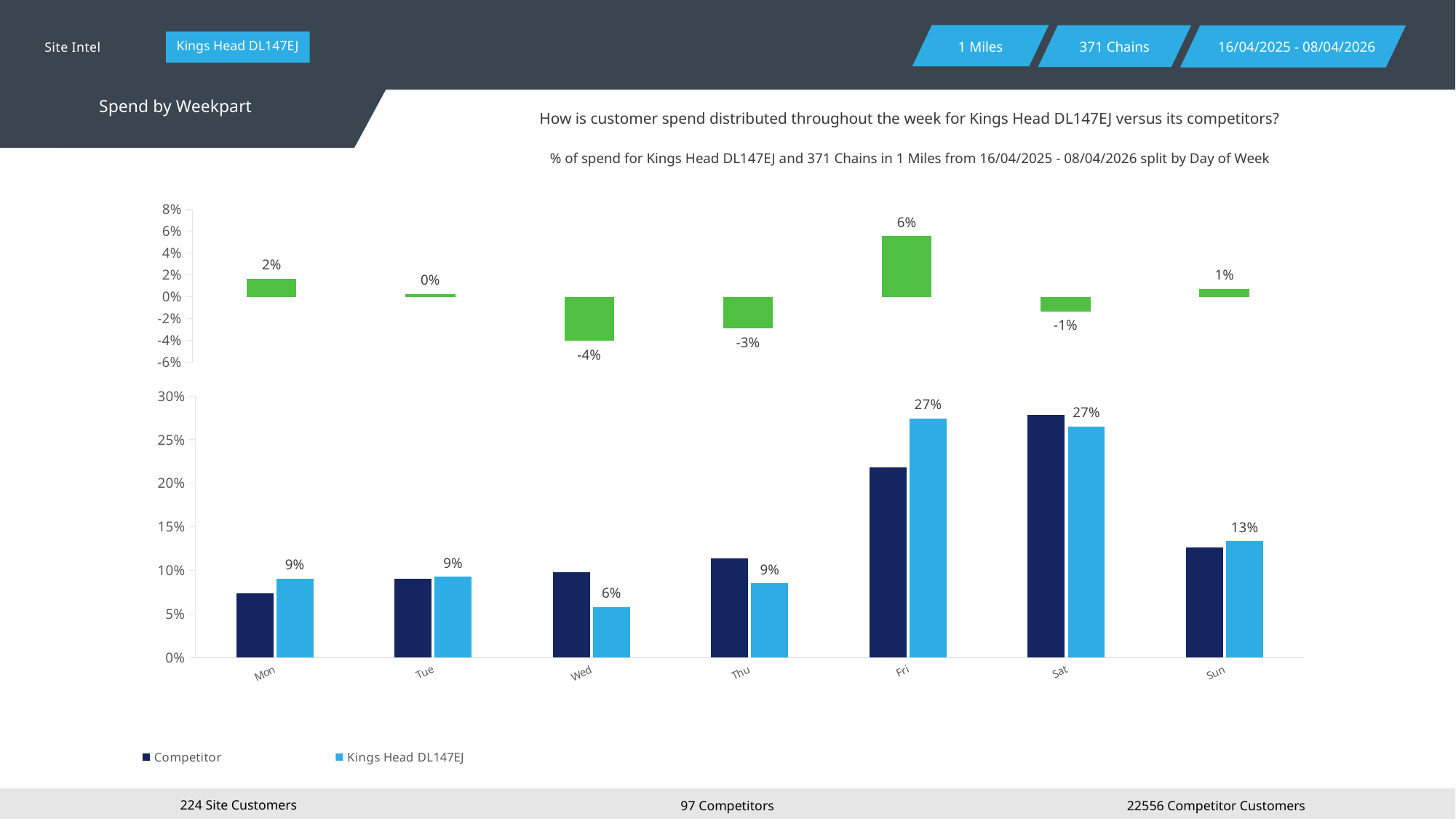
In the bottom chart, is the Competitor value for Fri greater or less than 25%? less In the bottom chart, what is the value for Kings Head DL147EJ on Fri? 27% In the bottom chart, what is the value for Kings Head DL147EJ on Wed? 6% How many series does the legend of the bottom chart list? 2 In the bottom chart, what is the difference between the Kings Head DL147EJ values for Fri and Sun? 14% In the top chart, what is the value shown for Fri? 6% In the bottom chart, which day has the lowest value for Kings Head DL147EJ? Wed In the top chart, what is the value shown for Wed? -4% How many days of the week are shown on the x axis of the bottom chart? 7 In the top chart, which day has the highest value? Fri In the top chart, which day has the lowest value? Wed In the bottom chart, is the Competitor value for Sat greater or less than 25%? greater